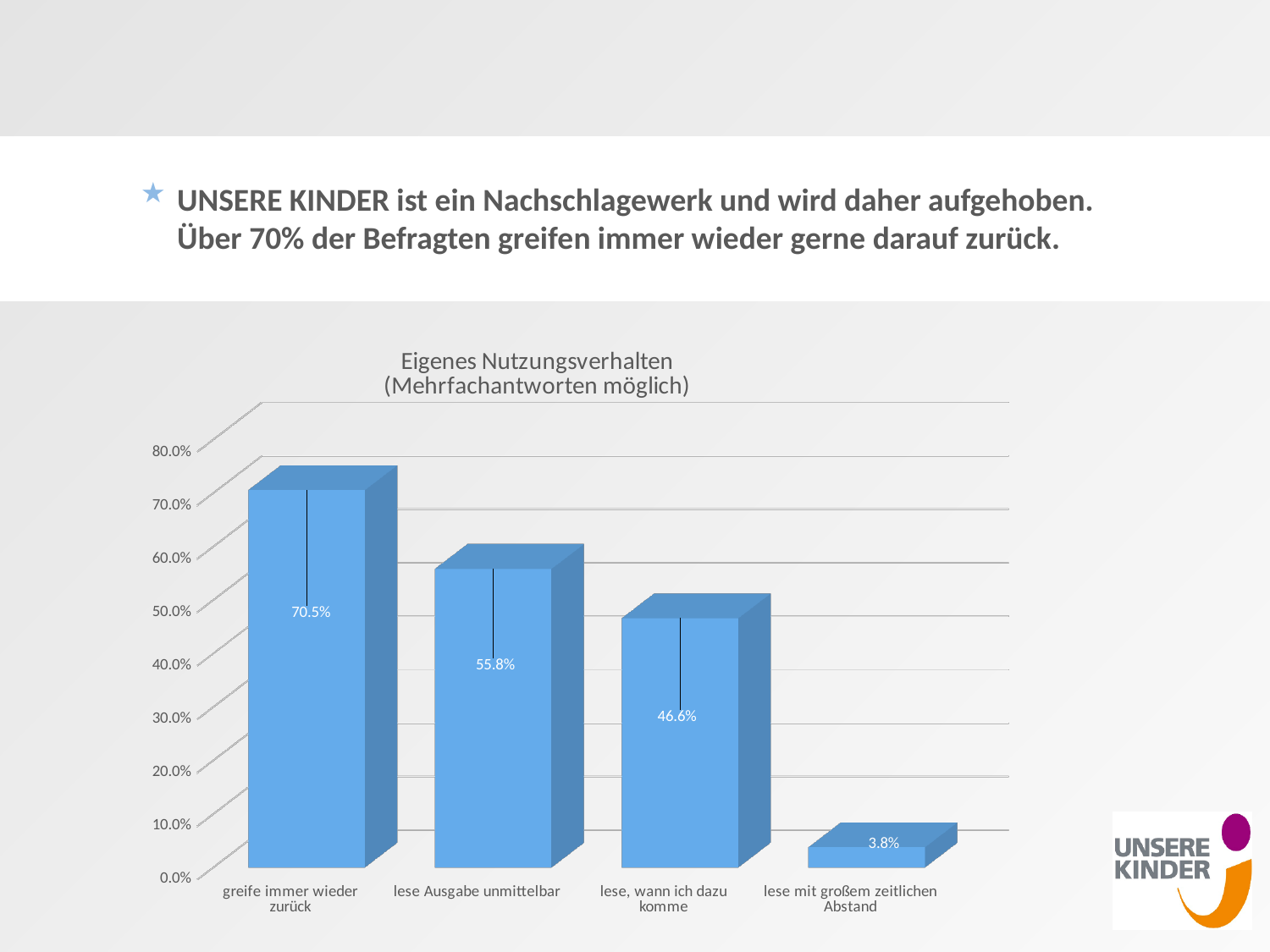
Which is larger: "lese Ausgabe unmittelbar" or "lese, wann ich dazu komme"? lese Ausgabe unmittelbar What is the value for "lese Ausgabe unmittelbar"? 55.8% What is the difference between "greife immer wieder zurück" and "lese Ausgabe unmittelbar"? 14.7% How many categories are shown in the chart? 4 What is the value for "greife immer wieder zurück"? 70.5% What is the value for "lese mit großem zeitlichen Abstand"? 3.8% What is the value for "lese, wann ich dazu komme"? 46.6% What is the title of the chart? Eigenes Nutzungsverhalten (Mehrfachantworten möglich) Is the value for "lese, wann ich dazu komme" greater or less than 50.0%? less Which category has the lowest value? lese mit großem zeitlichen Abstand Which category has the highest value? greife immer wieder zurück What kind of chart is shown on the slide? bar chart